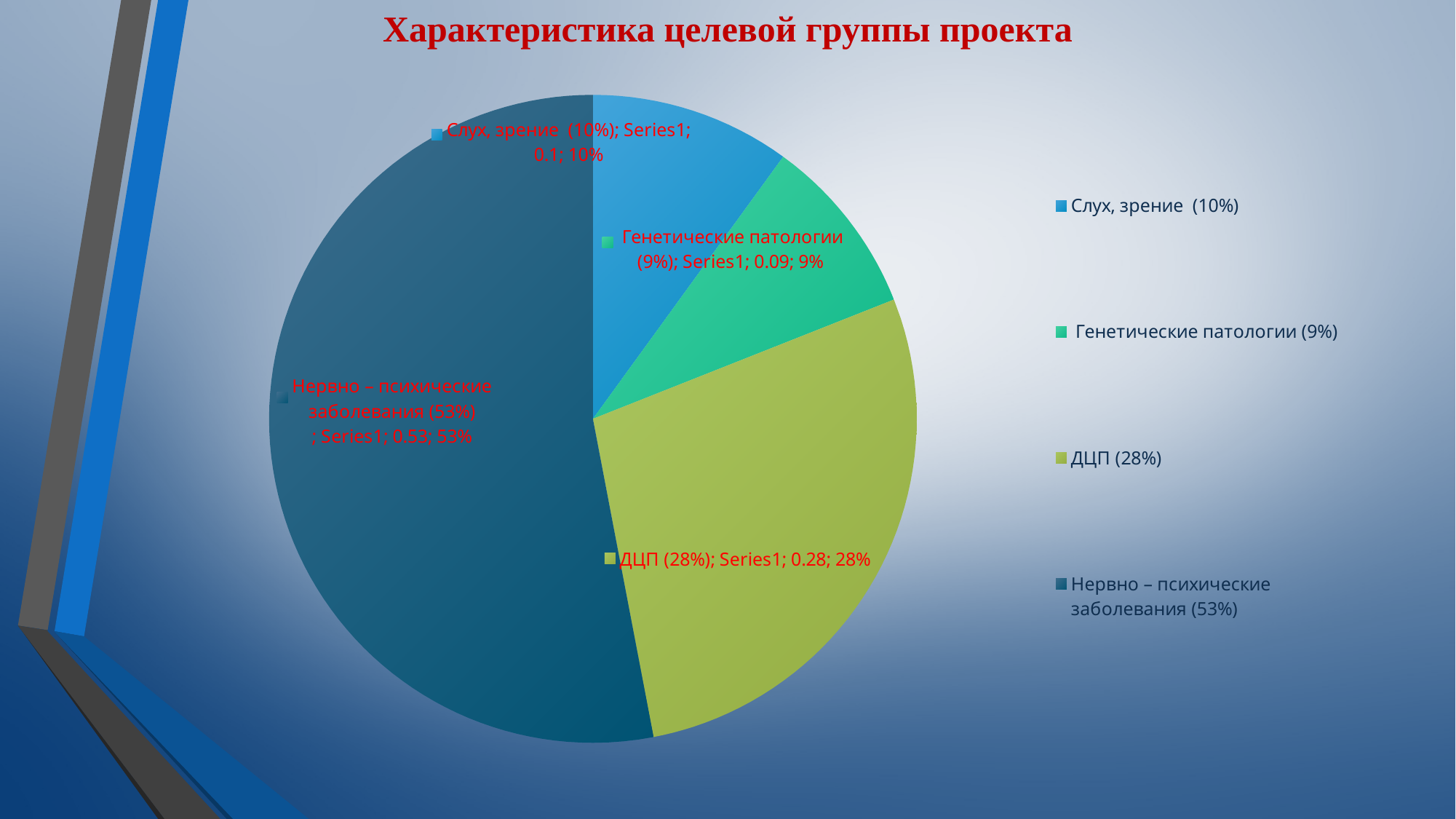
How many entries does the legend list? 4 What share of the pie does the slice for Нервно – психические заболевания represent? 53% Which category has the largest slice of the pie? Нервно – психические заболевания How many slices does the pie chart have? 4 What is the difference in percentage points between the Нервно – психические заболевания slice and the ДЦП slice? 25% What share of the pie does the slice for Слух, зрение represent? 10% What kind of chart is shown on the slide? pie chart What share of the pie does the slice for Генетические патологии represent? 9% Which category has the smallest slice of the pie? Генетические патологии Which slice is larger: ДЦП or Слух, зрение? ДЦП What is the title of the chart on the slide? Характеристика целевой группы проекта